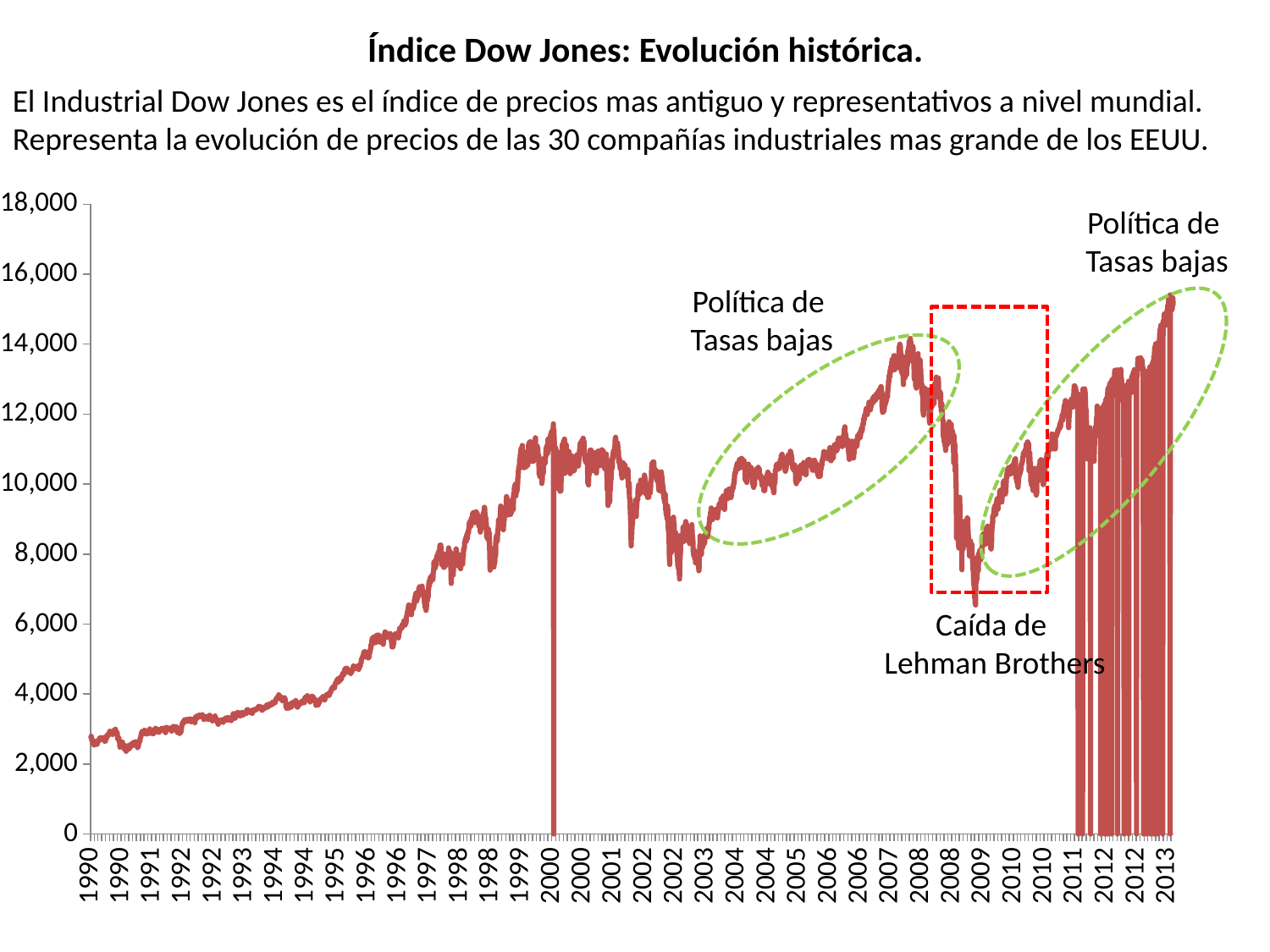
Does the index rise or fall between 2008 and early 2009? fall Is the value of the index at the start of 1990 greater or less than 4,000? less Is the peak value of the index in 2007 greater or less than 12,000? greater Is the value of the index in 1995 greater or less than 6,000? less What is the highest value shown on the y axis of the chart? 18,000 Which event is labelled inside the red dashed rectangle on the chart? Caída de Lehman Brothers What is the title of the slide containing the chart? Índice Dow Jones: Evolución histórica. What kind of chart is shown on the slide? line chart Overall, does the Dow Jones index rise or fall from 1990 to 2013 along the x axis? rise